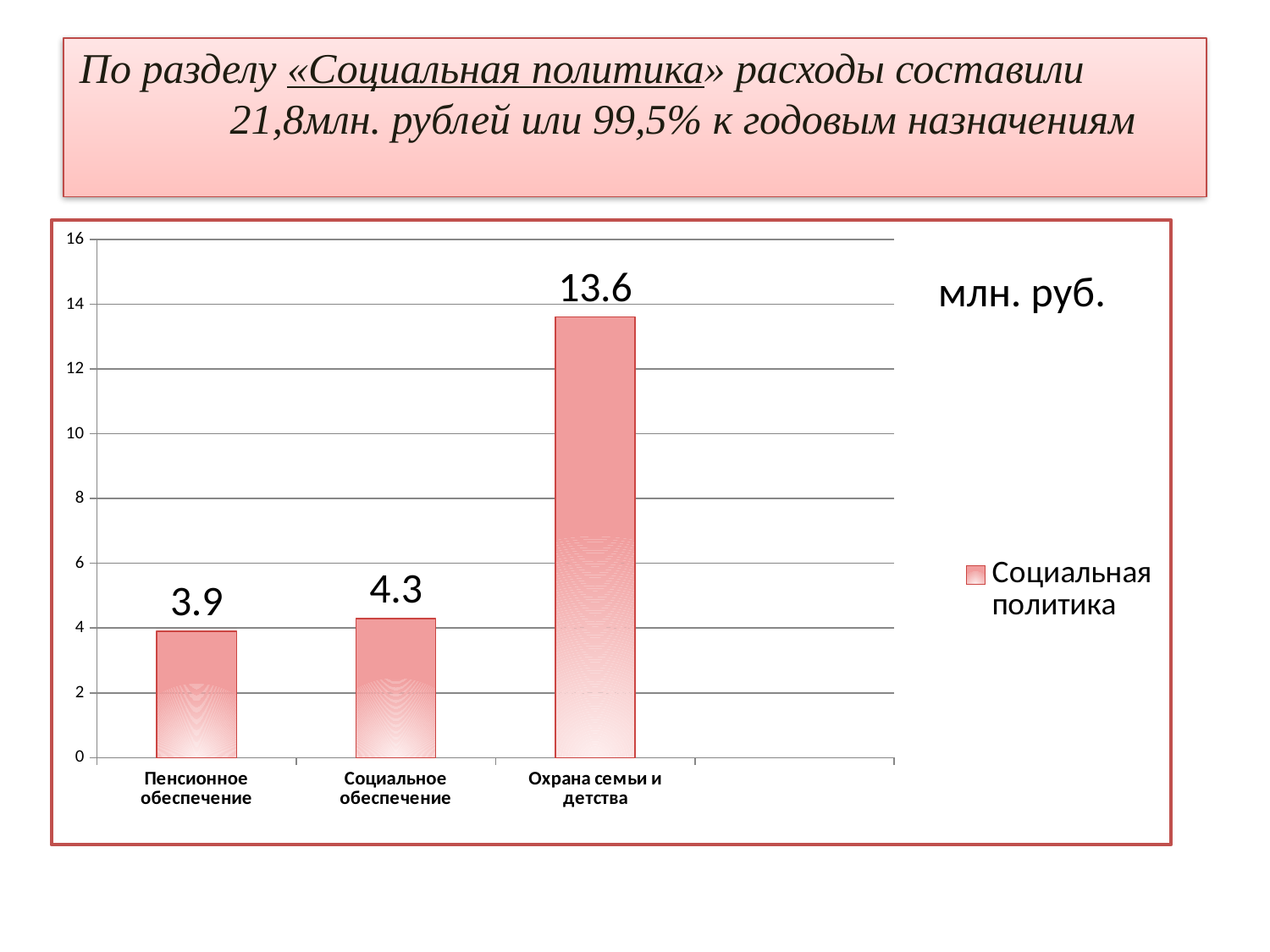
What is the value for Пенсионное обеспечение? 3.9 How many series does the legend list? 1 What is the difference between the values for Социальное обеспечение and Пенсионное обеспечение? 0.4 What is the value for Социальное обеспечение? 4.3 Which category has the highest value? Охрана семьи и детства Which is larger, the value for Охрана семьи и детства or the value for Пенсионное обеспечение? Охрана семьи и детства What is the value for Охрана семьи и детства? 13.6 What is the difference between the values for Охрана семьи и детства and Социальное обеспечение? 9.3 Is the value for Охрана семьи и детства greater or less than 12? greater Which category has the lowest value? Пенсионное обеспечение What kind of chart is shown on the slide? bar chart How many categories are shown on the x axis? 3